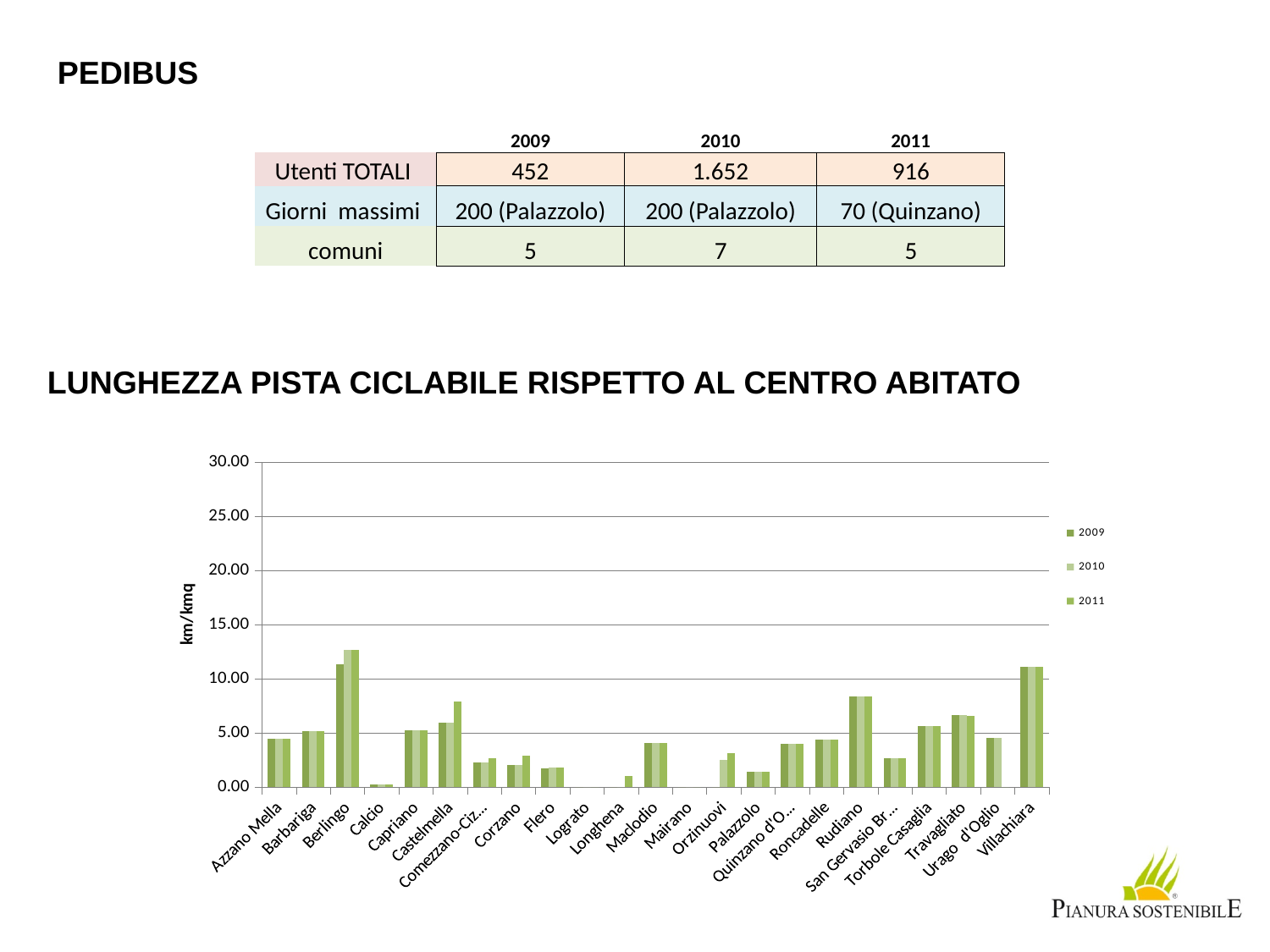
What is the label on the vertical axis of the bar chart? km/kmq In the bar chart, is the 2011 value for Rudiano greater or less than 10.00? less Which years are listed in the legend of the bar chart? 2009, 2010, 2011 In the bar chart, is the 2011 value for Castelmella greater or less than 5.00? greater What kind of chart is shown under the title 'LUNGHEZZA PISTA CICLABILE RISPETTO AL CENTRO ABITATO'? Bar chart How many municipalities (categories) are shown on the x axis of the bar chart? 23 How many series does the legend of the bar chart list? 3 In the bar chart, which municipality has the highest value? Berlingo In the bar chart, is the 2011 value for Villachiara greater or less than 10.00? greater In the bar chart, which has the higher 2011 value, Berlingo or Villachiara? Berlingo In the bar chart, which has the higher 2011 value, Rudiano or Torbole Casaglia? Rudiano